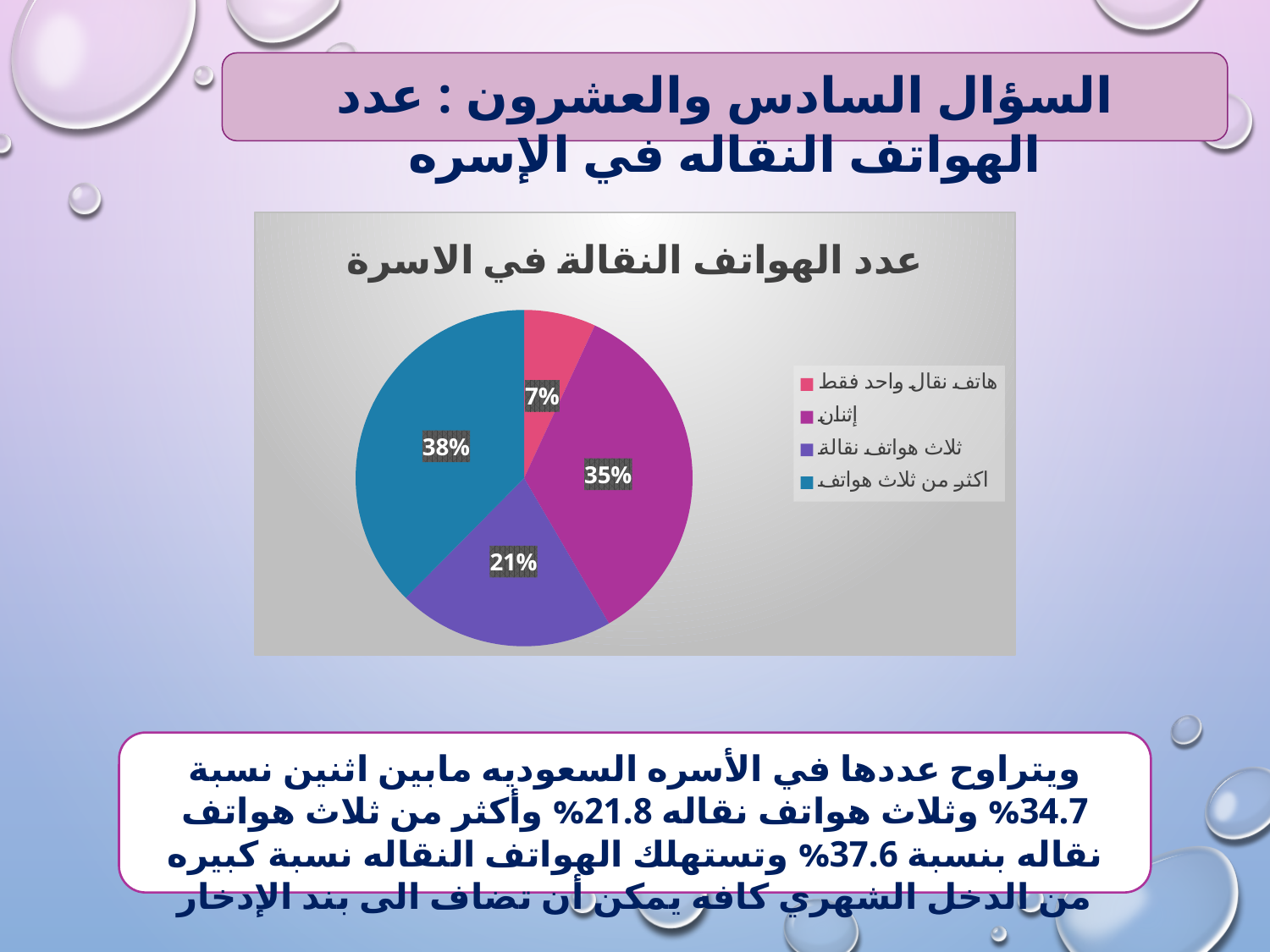
What percentage of the pie is labelled for the category "اكثر من ثلاث هواتف"? 38% Which slice is larger: "إثنان" or "اكثر من ثلاث هواتف"? اكثر من ثلاث هواتف Which category has the largest share of the pie? اكثر من ثلاث هواتف What is the difference in percentage points between the "إثنان" slice and the "ثلاث هواتف نقالة" slice? 14 percentage points What kind of chart is shown on the slide? Pie chart What percentage of the pie is labelled for the category "هاتف نقال واحد فقط"? 7% How many categories (slices) does the pie chart have? 4 Which category has the smallest share of the pie? هاتف نقال واحد فقط What colour is the slice for "اكثر من ثلاث هواتف"? Teal (blue) What percentage of the pie is labelled for the category "ثلاث هواتف نقالة"? 21% What percentage of the pie is labelled for the category "إثنان"? 35% What is the title of the chart? عدد الهواتف النقالة في الاسرة